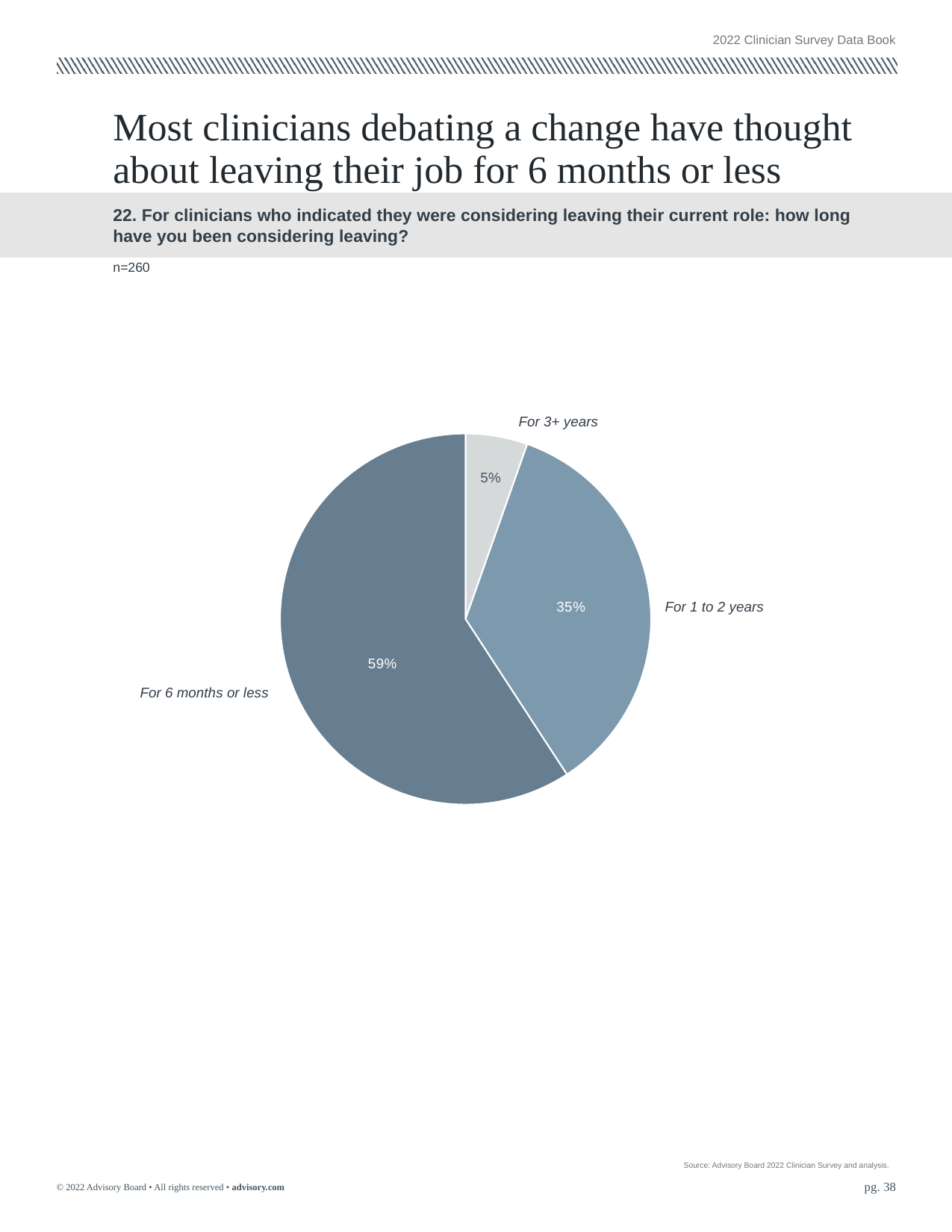
What share of clinicians have been considering leaving for 3+ years? 5% What is the difference in percentage points between 'For 1 to 2 years' and 'For 3+ years'? 30 percentage points Which category has the smallest share of the pie? For 3+ years Which category has the largest share of the pie? For 6 months or less What share of clinicians have been considering leaving for 1 to 2 years? 35% What is the sample size (n) reported for this chart? n=260 Which is larger: the share for 'For 1 to 2 years' or 'For 3+ years'? For 1 to 2 years Which category is shown in the lightest grey slice? For 3+ years How many categories are shown in the pie chart? 3 What kind of chart is shown on the slide? Pie chart What is the difference in percentage points between 'For 6 months or less' and 'For 1 to 2 years'? 24 percentage points What share of clinicians have been considering leaving for 6 months or less? 59%